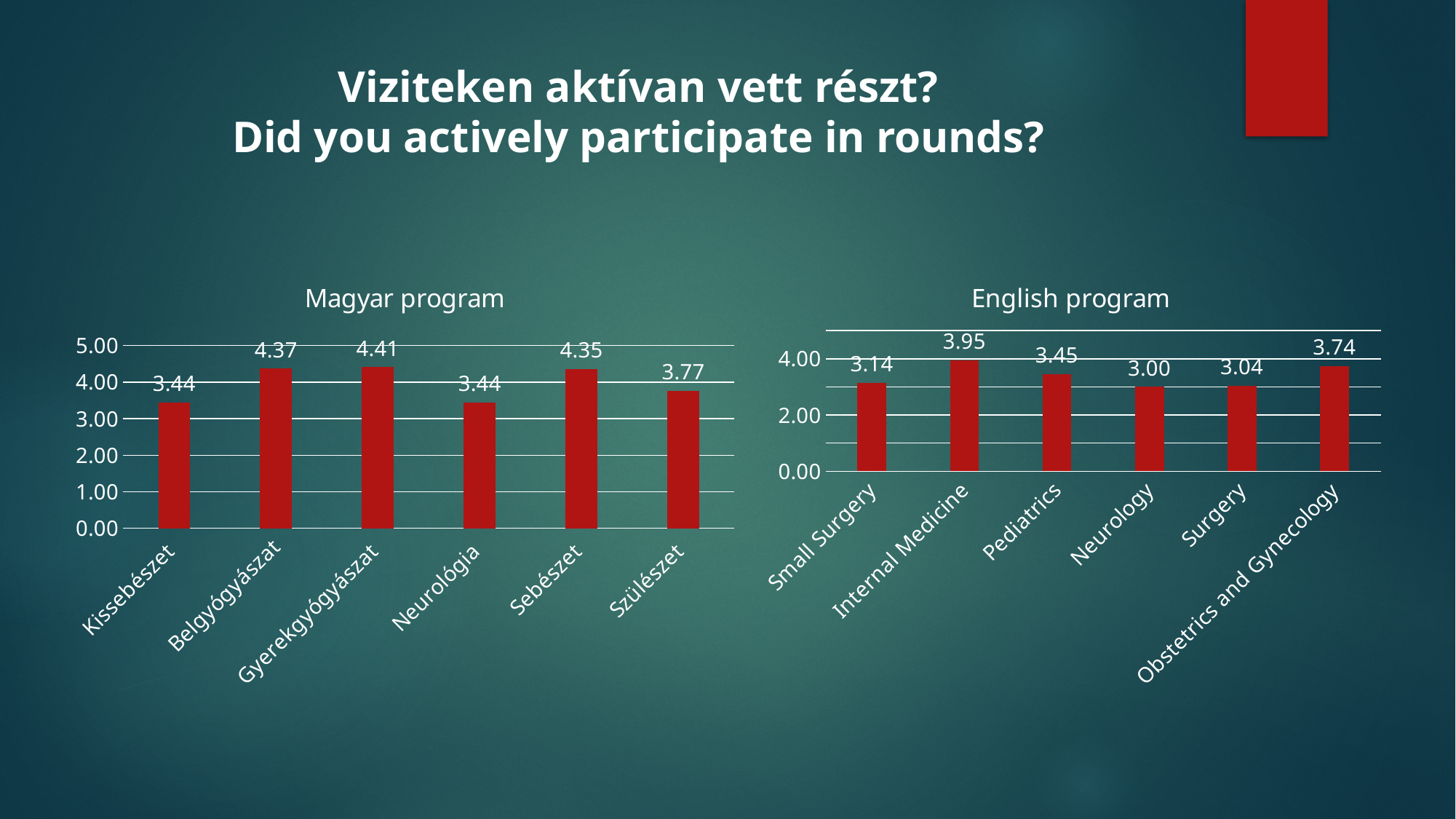
How many categories are shown in the English program chart? 6 In the Magyar program chart, what is the difference between Gyerekgyógyászat and Szülészet? 0.64 In the English program chart, which category has the lowest value? Neurology In the English program chart, which category has the highest value? Internal Medicine In the Magyar program chart, which category has the highest value? Gyerekgyógyászat In the Magyar program chart, what is the value for Belgyógyászat? 4.37 In the English program chart, what is the difference between Obstetrics and Gynecology and Small Surgery? 0.60 In the English program chart, is the value for Pediatrics greater or less than 4.00? less In the English program chart, what is the value for Internal Medicine? 3.95 In the Magyar program chart, which is larger, Sebészet or Szülészet? Sebészet What is the title of the chart on the right side of the slide? English program What kind of chart is the Magyar program chart? bar chart